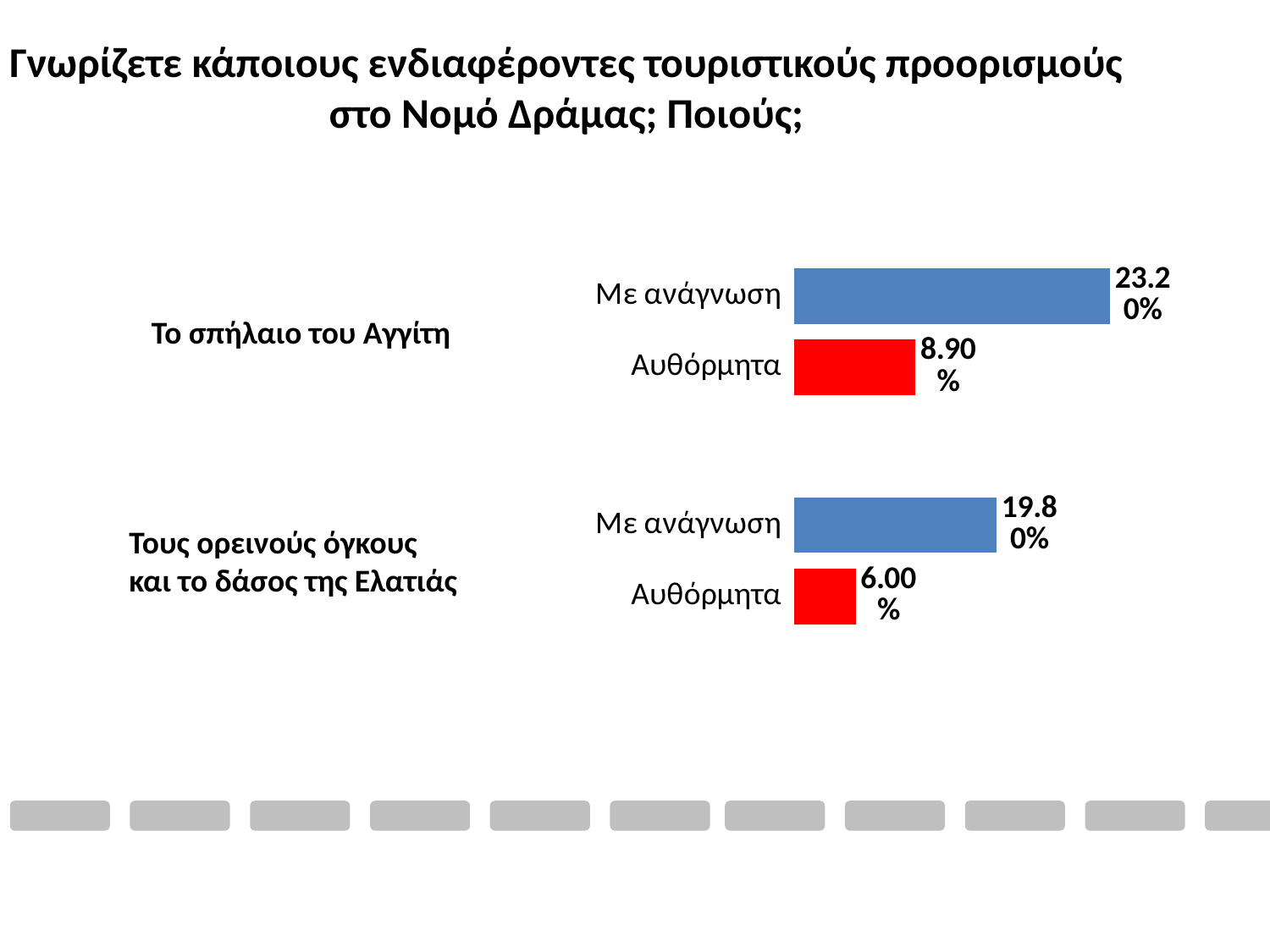
What type of chart is used for Τους ορεινούς όγκους και το δάσος της Ελατιάς? Bar chart In the chart for Το σπήλαιο του Αγγίτη, what colour is the Αυθόρμητα bar? Red In the chart for Το σπήλαιο του Αγγίτη, what is the value for Αυθόρμητα? 8.90% In the chart for Το σπήλαιο του Αγγίτη, what is the value for Με ανάγνωση? 23.20% In the chart for Το σπήλαιο του Αγγίτη, what is the difference between Με ανάγνωση and Αυθόρμητα? 14.30% In the chart for Το σπήλαιο του Αγγίτη, which category has the highest value? Με ανάγνωση In the chart for Τους ορεινούς όγκους και το δάσος της Ελατιάς, which category has the lowest value? Αυθόρμητα In the chart for Τους ορεινούς όγκους και το δάσος της Ελατιάς, what is the value for Με ανάγνωση? 19.80% How many bars are shown in the chart for Το σπήλαιο του Αγγίτη? 2 Which is larger: Με ανάγνωση for Το σπήλαιο του Αγγίτη or Με ανάγνωση for Τους ορεινούς όγκους και το δάσος της Ελατιάς? Με ανάγνωση for Το σπήλαιο του Αγγίτη In the chart for Τους ορεινούς όγκους και το δάσος της Ελατιάς, what is the value for Αυθόρμητα? 6.00% In the chart for Τους ορεινούς όγκους και το δάσος της Ελατιάς, what is the difference between Με ανάγνωση and Αυθόρμητα? 13.80%